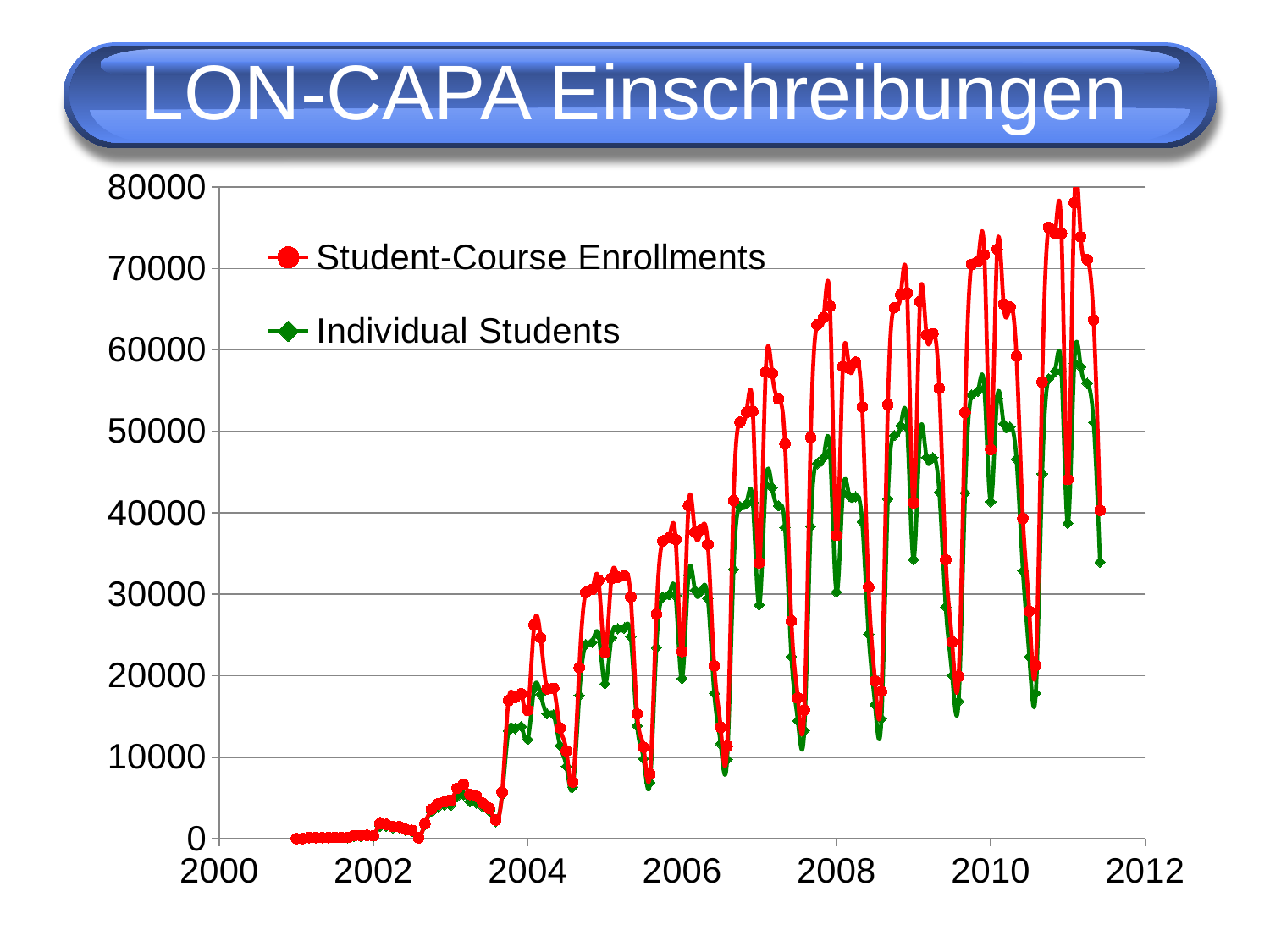
Overall, do the values for Student-Course Enrollments rise or fall from 2001 to 2011? rise What is the highest value shown on the vertical axis? 80000 Which series is drawn in red with circle markers? Student-Course Enrollments Is the highest value for Individual Students greater or less than 70000? less Is the highest value for Student-Course Enrollments greater or less than 70000? greater Which series generally has the higher values, Student-Course Enrollments or Individual Students? Student-Course Enrollments Is the peak value for Individual Students in 2011 greater or less than 50000? greater How many series does the legend list? 2 What kind of chart is shown on the slide? line chart What are the two series named in the legend? Student-Course Enrollments and Individual Students